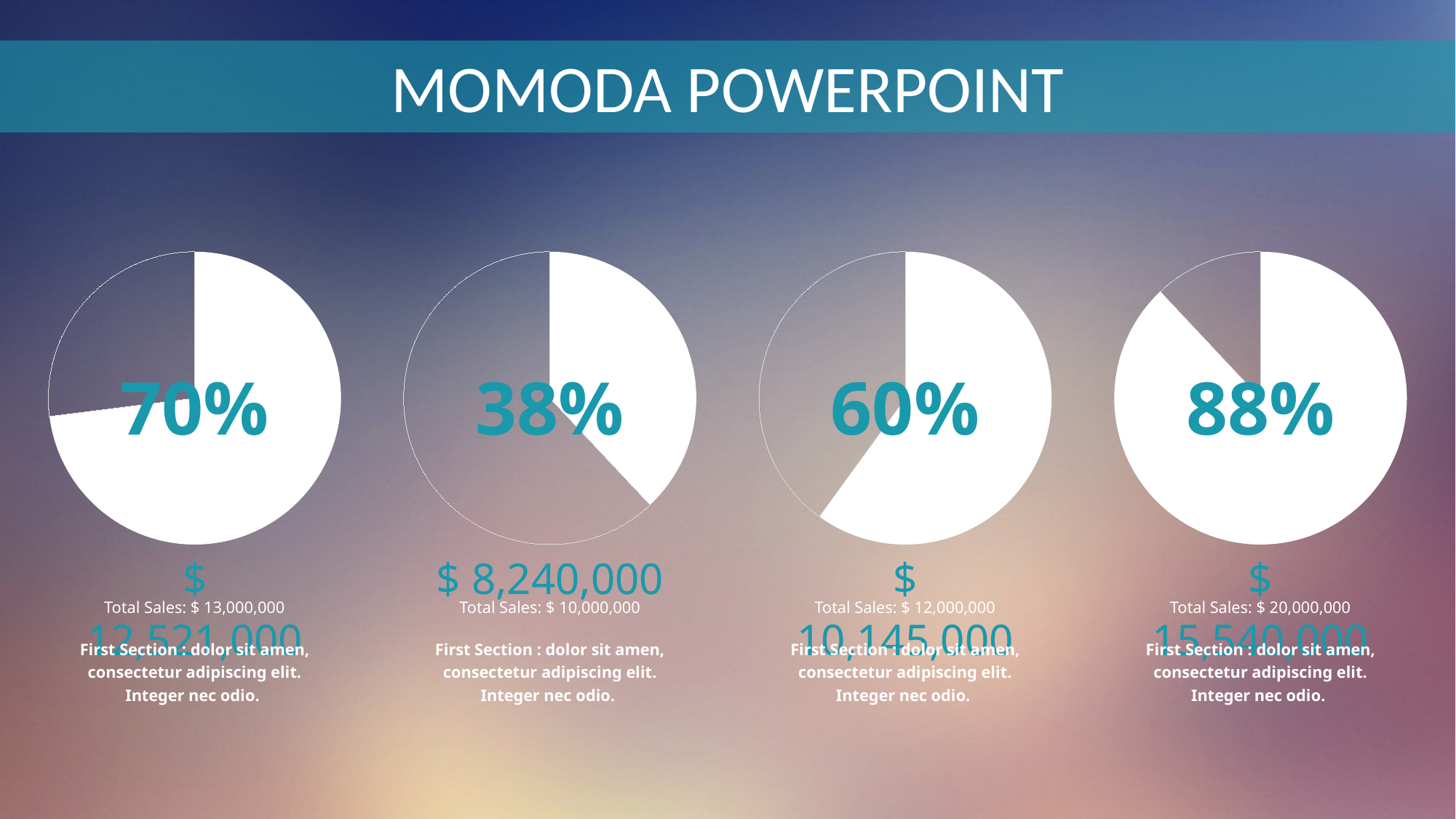
What is the Total Sales value printed under the second pie chart from the left? $ 10,000,000 What percentage is shown on the second pie chart from the left? 38% What kind of chart is used on this slide? Pie chart What percentage is shown on the third pie chart from the left? 60% Which is larger: the percentage on the leftmost pie chart or the percentage on the third pie chart from the left? The leftmost pie chart (70%) What percentage is shown on the leftmost pie chart? 70% What is the title of the slide containing the pie charts? MOMODA POWERPOINT What is the difference between the percentage on the rightmost pie chart and the percentage on the leftmost pie chart? 18% Which pie chart shows the highest percentage? The rightmost pie chart (88%) Which pie chart shows the lowest percentage? The second pie chart from the left (38%) How many pie charts are on the slide? 4 What percentage is shown on the rightmost pie chart? 88%